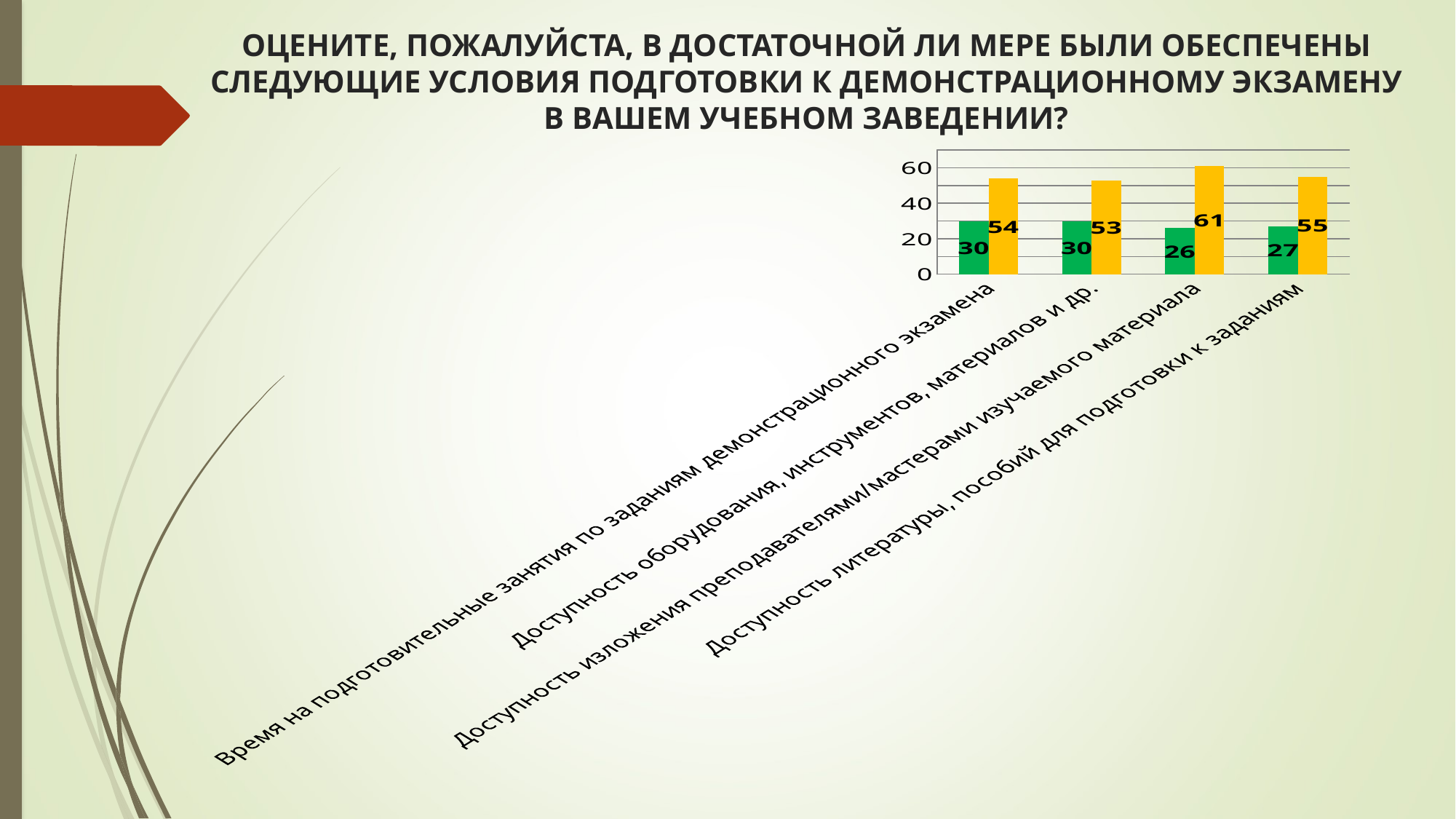
What two colours are used for the bars in the chart? Green and yellow Which is larger: the yellow bar for "Время на подготовительные занятия по заданиям демонстрационного экзамена" or the yellow bar for "Доступность изложения преподавателями/мастерами изучаемого материала"? Доступность изложения преподавателями/мастерами изучаемого материала What is the value of the yellow bar for "Доступность изложения преподавателями/мастерами изучаемого материала"? 61 How many categories are shown on the x axis of the chart? 4 What is the value of the yellow bar for "Время на подготовительные занятия по заданиям демонстрационного экзамена"? 54 What is the difference between the yellow bars for "Доступность литературы, пособий для подготовки к заданиям" and "Доступность оборудования, инструментов, материалов и др."? 2 What is the value of the green bar for "Доступность оборудования, инструментов, материалов и др."? 30 Which category has the highest yellow bar? Доступность изложения преподавателями/мастерами изучаемого материала What is the value of the green bar for "Доступность литературы, пособий для подготовки к заданиям"? 27 What is the difference between the yellow and green bars for "Доступность изложения преподавателями/мастерами изучаемого материала"? 35 What type of chart is shown on the slide? Bar chart Which category has the lowest green bar? Доступность изложения преподавателями/мастерами изучаемого материала